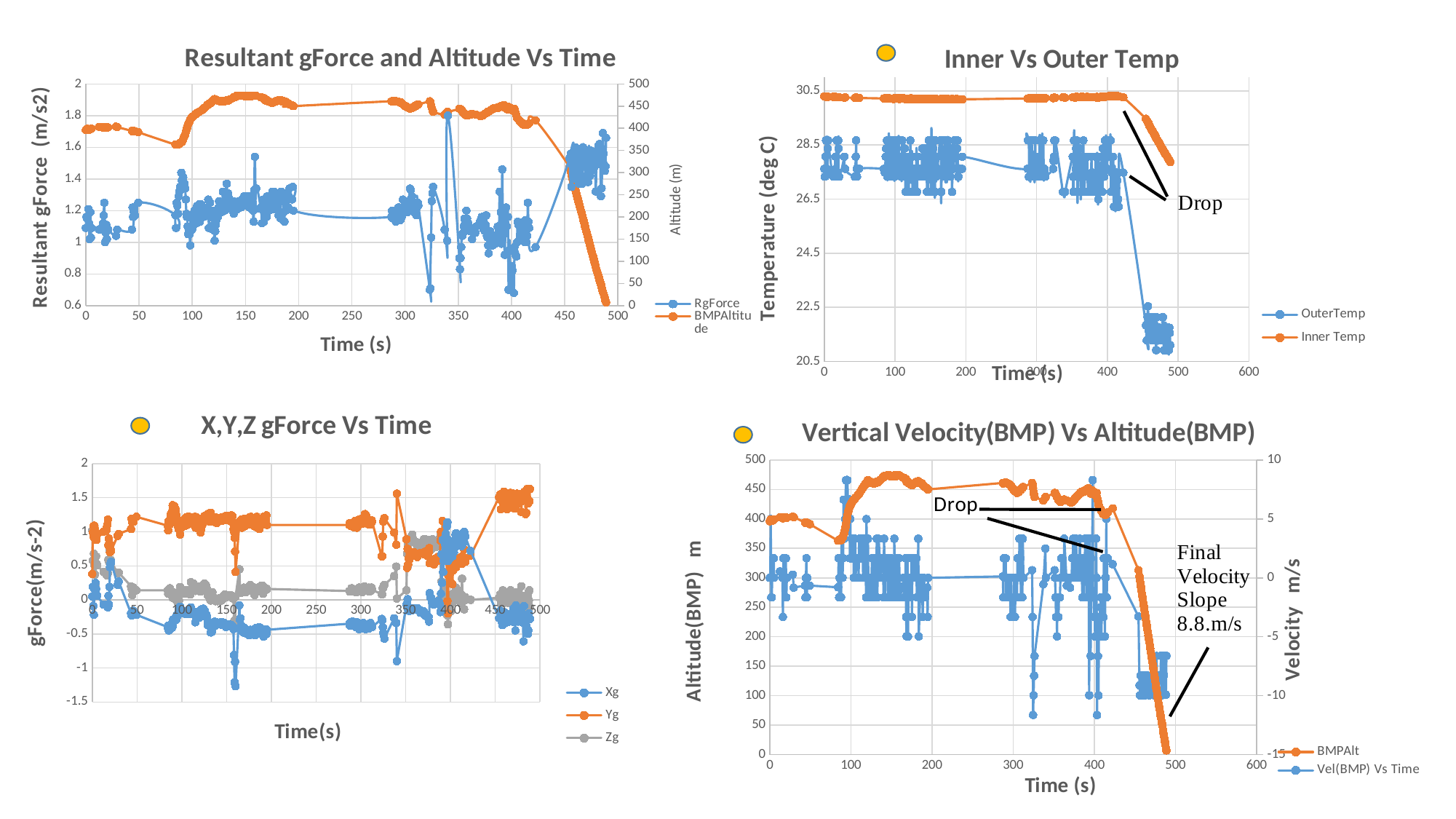
In the 'Resultant gForce and Altitude Vs Time' chart, is the BMPAltitude value at time 150 s greater or less than 450? greater In the 'X,Y,Z gForce Vs Time' chart, is the Yg value at time 100 s greater or less than 1? greater In the 'X,Y,Z gForce Vs Time' chart, which series has the larger value at time 300 s, Xg or Yg? Yg In the 'Inner Vs Outer Temp' chart, is the Inner Temp value at time 100 s greater or less than 28.5? greater What kind of chart is the 'Resultant gForce and Altitude Vs Time' chart? Line chart What are the two legend entries of the 'Vertical Velocity(BMP) Vs Altitude(BMP)' chart? BMPAlt and Vel(BMP) Vs Time In the 'Inner Vs Outer Temp' chart, which series has the higher value at time 200 s, Inner Temp or OuterTemp? Inner Temp In the 'Vertical Velocity(BMP) Vs Altitude(BMP)' chart, what final velocity slope is stated in the annotation? 8.8 m/s How many series does the legend of the 'Inner Vs Outer Temp' chart list? 2 How many series does the legend of the 'X,Y,Z gForce Vs Time' chart list? 3 In the 'Inner Vs Outer Temp' chart, does the Inner Temp series rise or fall after about 420 s? fall